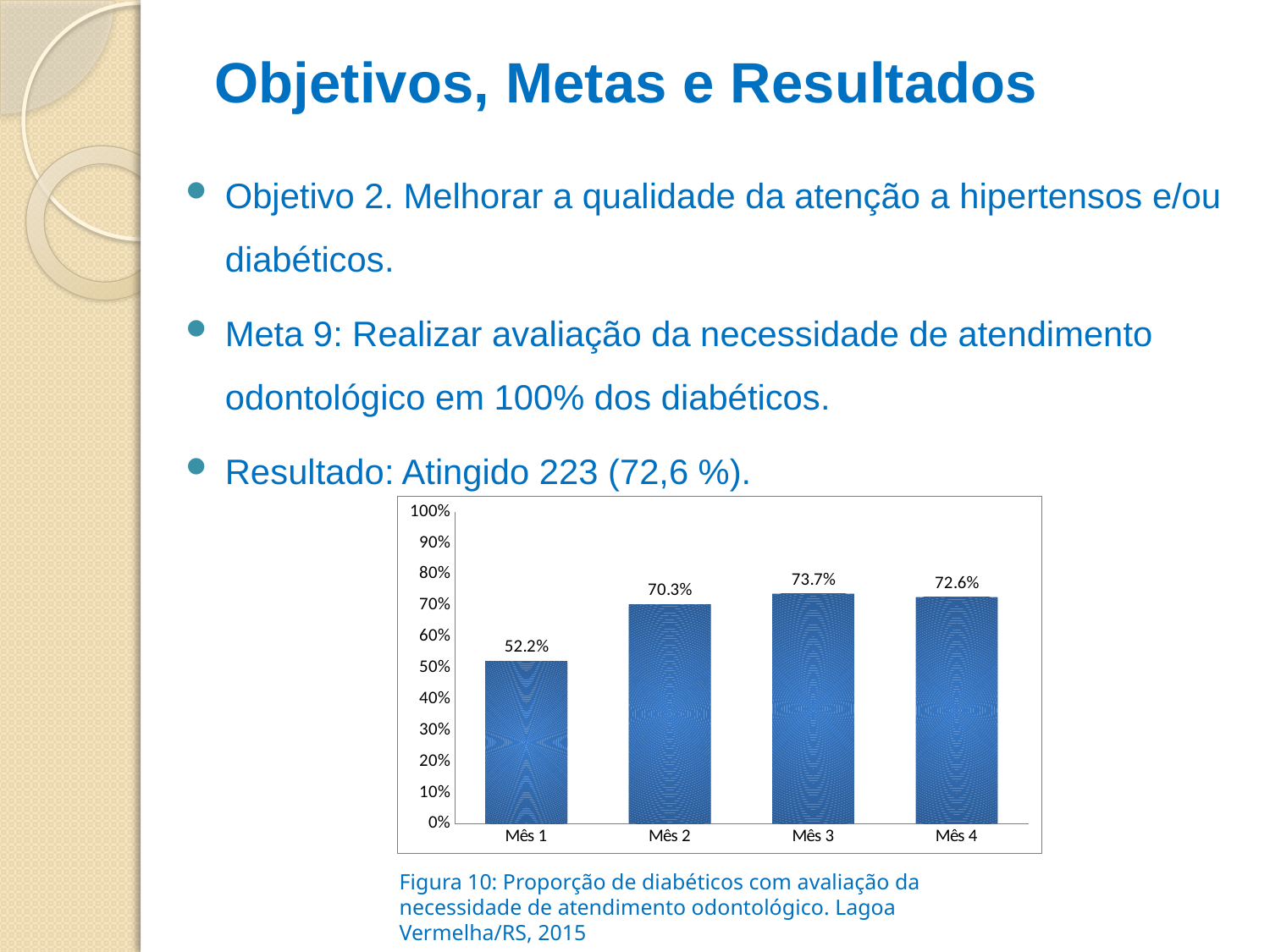
What kind of chart is shown on the slide? bar chart Which month has the highest value? Mês 3 What is the difference between the values for Mês 2 and Mês 1? 18.1% Is the value for Mês 1 greater or less than 60%? less What is the value for Mês 3? 73.7% How many months are shown on the x axis? 4 What is the value for Mês 4? 72.6% What is the difference between the values for Mês 3 and Mês 4? 1.1% Which month has the lowest value? Mês 1 What is the value for Mês 1? 52.2% What is the highest value shown on the y axis? 100% Which is larger, the value for Mês 2 or the value for Mês 1? Mês 2